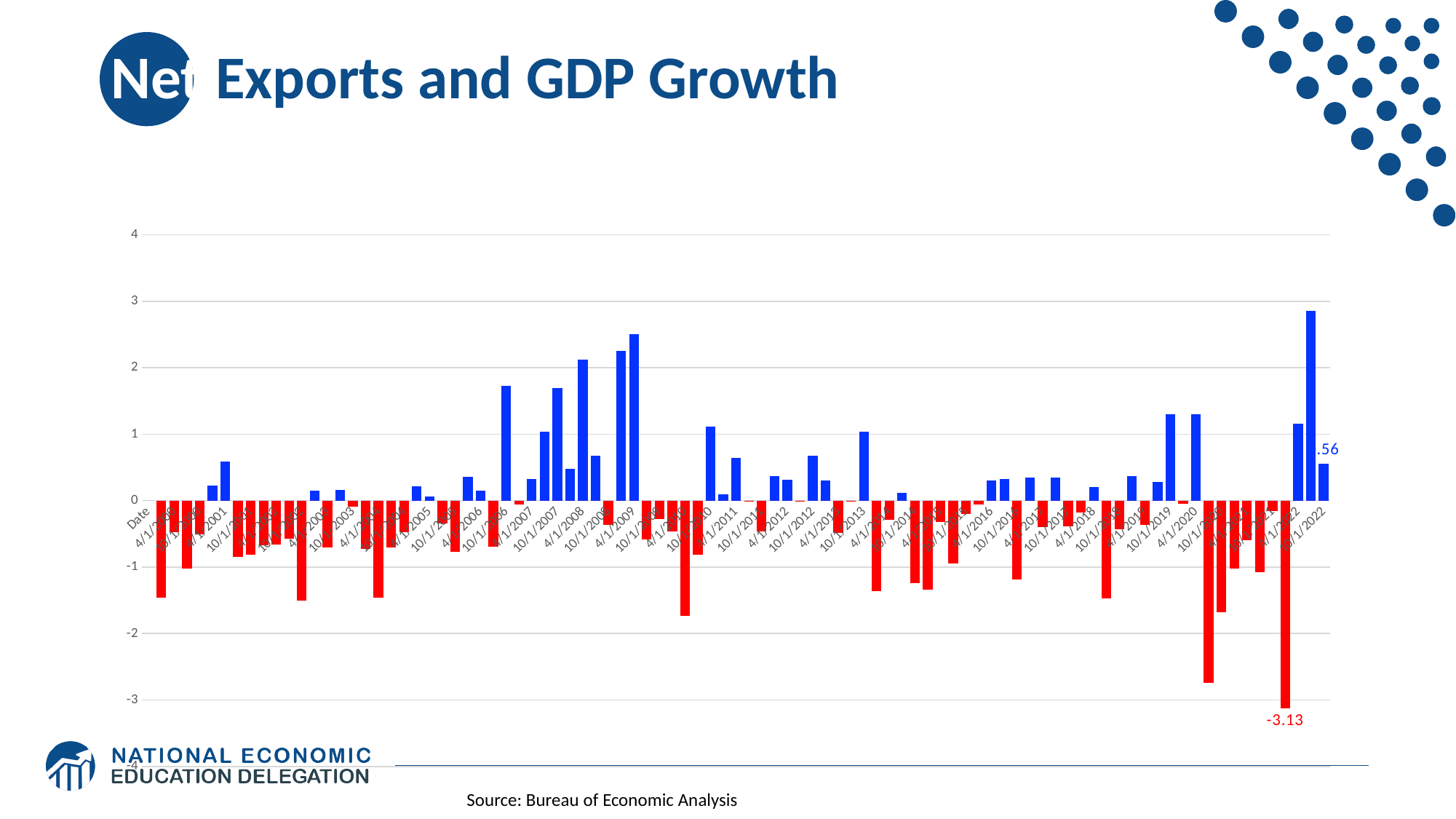
What is the lowest value shown on the chart? -3.13 Is the lowest value on the chart greater or less than -3? less What source is cited for the chart? Bureau of Economic Analysis Is the highest value on the chart greater or less than 3? less What kind of chart is shown on the slide? bar chart What is the highest tick value shown on the vertical axis? 4 Is the highest value on the chart greater or less than 2? greater